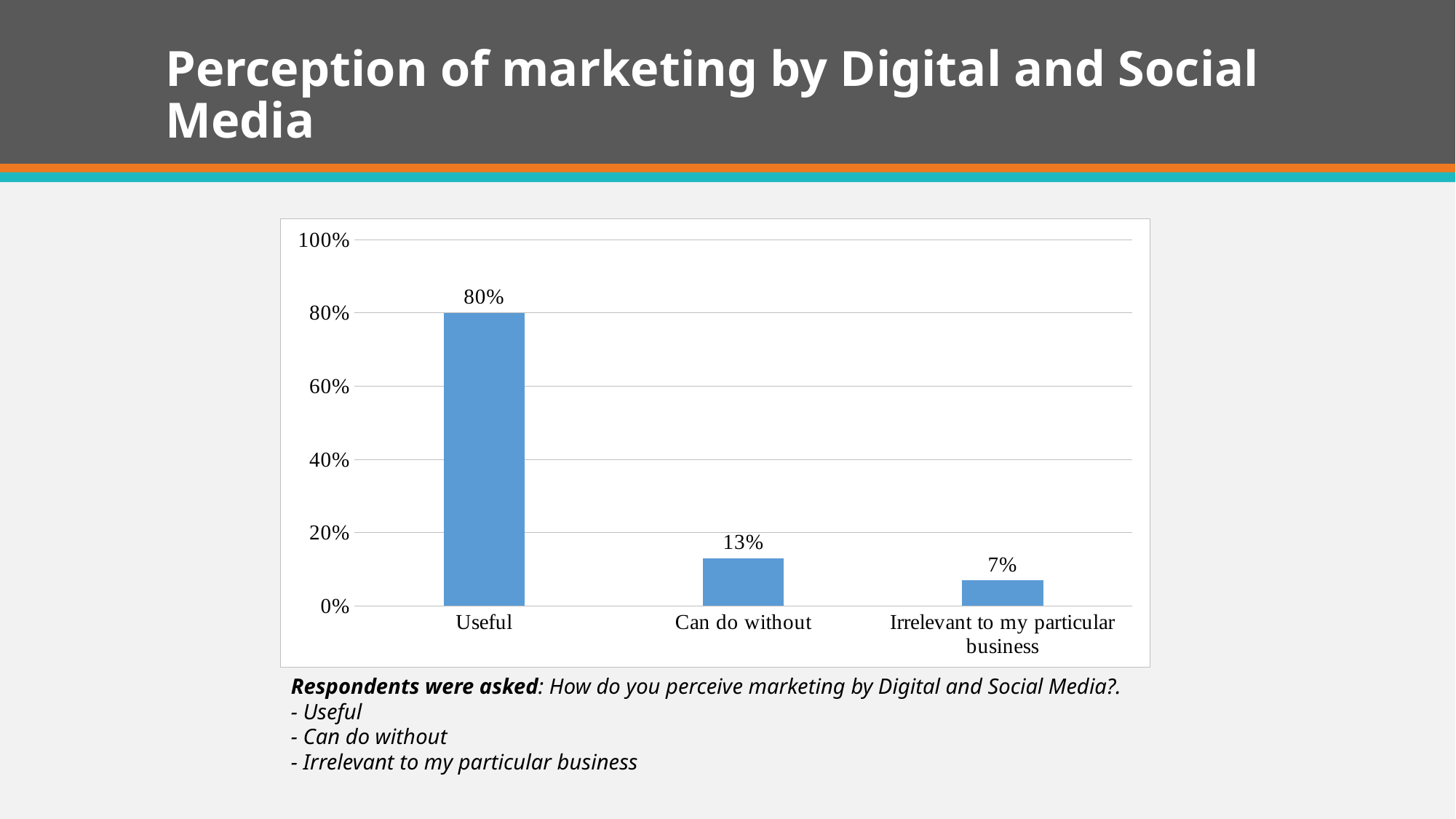
What kind of chart is shown on the slide? Bar chart Do the values rise or fall from left to right along the x axis? Fall What is the value for the 'Can do without' category? 13% Which is larger, the value for 'Can do without' or for 'Irrelevant to my particular business'? Can do without Which category has the highest value? Useful What is the difference between the 'Can do without' and 'Irrelevant to my particular business' values? 6% Which category has the lowest value? Irrelevant to my particular business What is the difference between the 'Useful' and 'Can do without' values? 67% What percentage of respondents perceive marketing by Digital and Social Media as Useful? 80% How many categories are shown on the x axis? 3 Is the value for 'Useful' greater or less than 60%? greater What is the value for 'Irrelevant to my particular business'? 7%